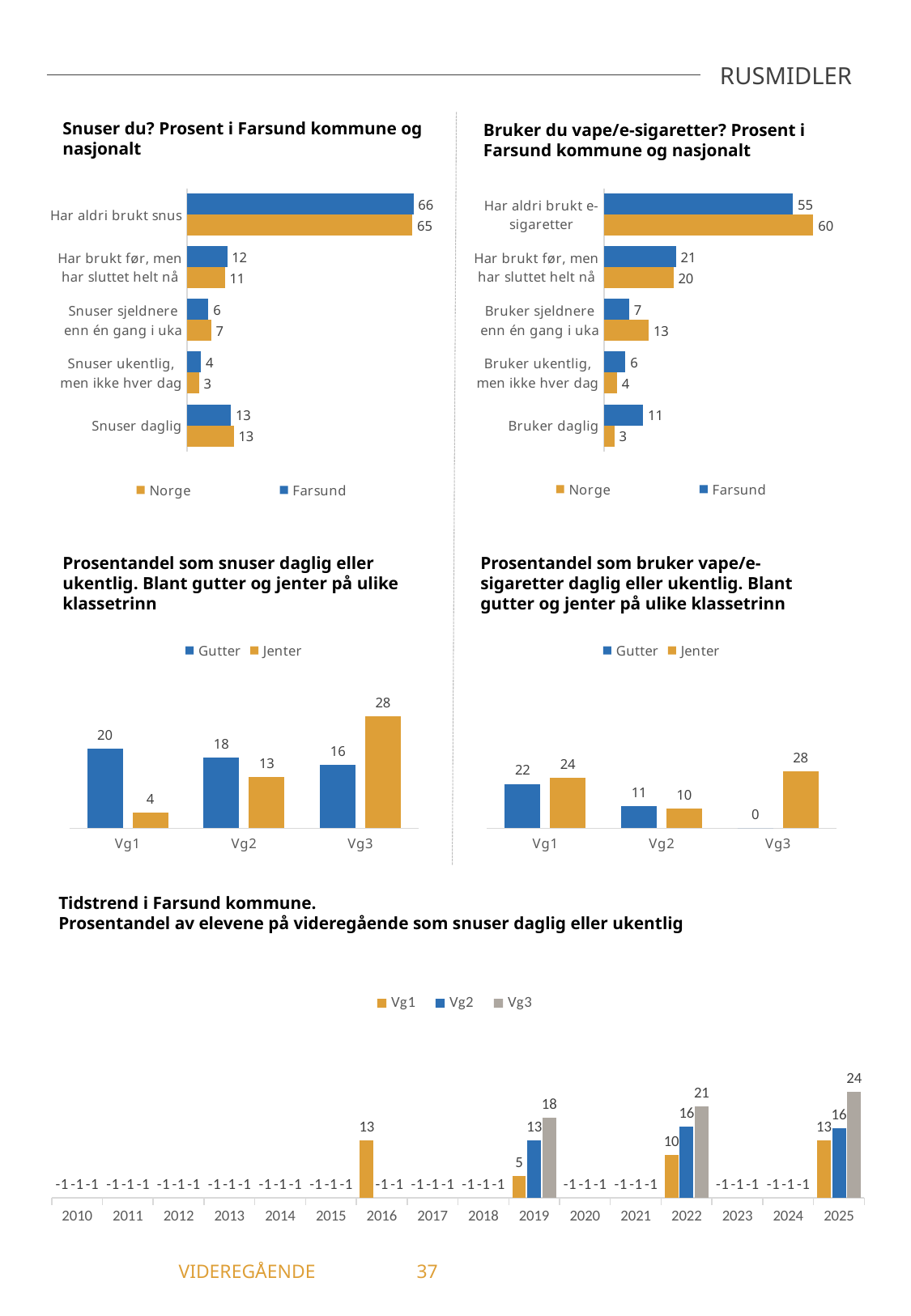
In the chart 'Prosentandel som snuser daglig eller ukentlig. Blant gutter og jenter på ulike klassetrinn', what is the value for Jenter in Vg3? 28 In the chart 'Prosentandel som snuser daglig eller ukentlig. Blant gutter og jenter på ulike klassetrinn', do the Gutter values rise or fall from Vg1 to Vg3? fall In the chart 'Snuser du? Prosent i Farsund kommune og nasjonalt', what is the difference between the Farsund and Norge values for 'Har brukt før, men har sluttet helt nå'? 1 In the chart 'Tidstrend i Farsund kommune', how many series does the legend list? 3 In the chart 'Prosentandel som bruker vape/e-sigaretter daglig eller ukentlig. Blant gutter og jenter på ulike klassetrinn', what is the value for Gutter in Vg3? 0 In the chart 'Tidstrend i Farsund kommune', what is the Vg3 value for 2025? 24 In the chart 'Snuser du? Prosent i Farsund kommune og nasjonalt', what is the value for Farsund for 'Har aldri brukt snus'? 66 In the chart 'Bruker du vape/e-sigaretter? Prosent i Farsund kommune og nasjonalt', what is the Norge value for 'Bruker daglig'? 3 In the chart 'Prosentandel som bruker vape/e-sigaretter daglig eller ukentlig. Blant gutter og jenter på ulike klassetrinn', which class level has the highest Jenter value? Vg3 In the chart 'Bruker du vape/e-sigaretter? Prosent i Farsund kommune og nasjonalt', how many response categories are shown? 5 In the chart 'Bruker du vape/e-sigaretter? Prosent i Farsund kommune og nasjonalt', which is larger for 'Bruker sjeldnere enn én gang i uka': Farsund or Norge? Norge What kind of chart is 'Tidstrend i Farsund kommune'? bar chart